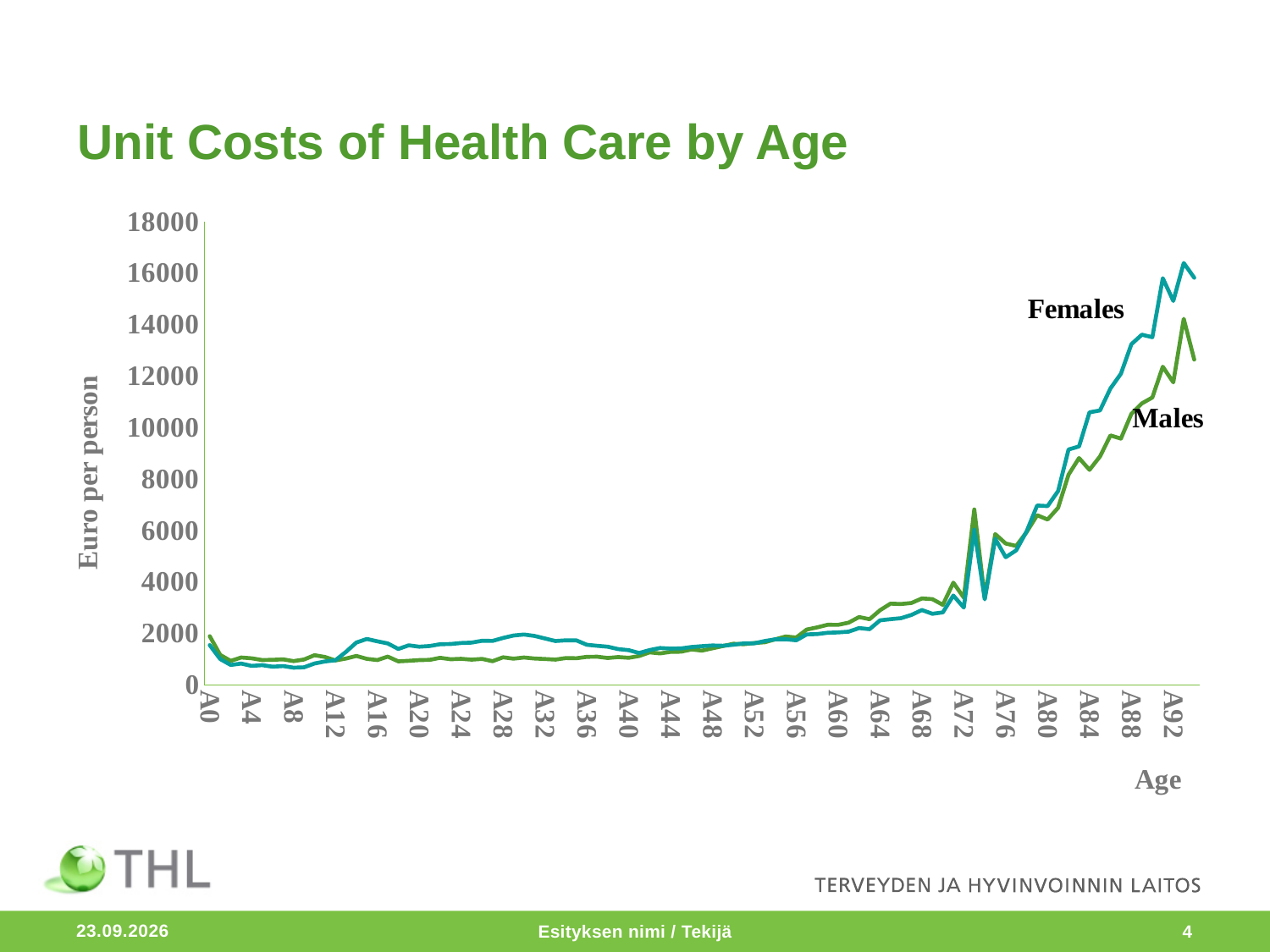
What is the label of the vertical axis? Euro per person What kind of chart is shown on the slide? line chart Is the value for Males at A80 greater or less than 8000? less How many series are plotted on the chart? 2 Is the value for Females at A92 greater or less than 14000? greater Do the values for Males rise or fall from A0 to A4? fall Do the values for Females rise or fall from A72 to A92? rise At A16, which series has the higher value, Females or Males? Females Is the value for Females at A40 greater or less than 4000? less At A88, which series has the higher value, Females or Males? Females What is the title of the chart on the slide? Unit Costs of Health Care by Age